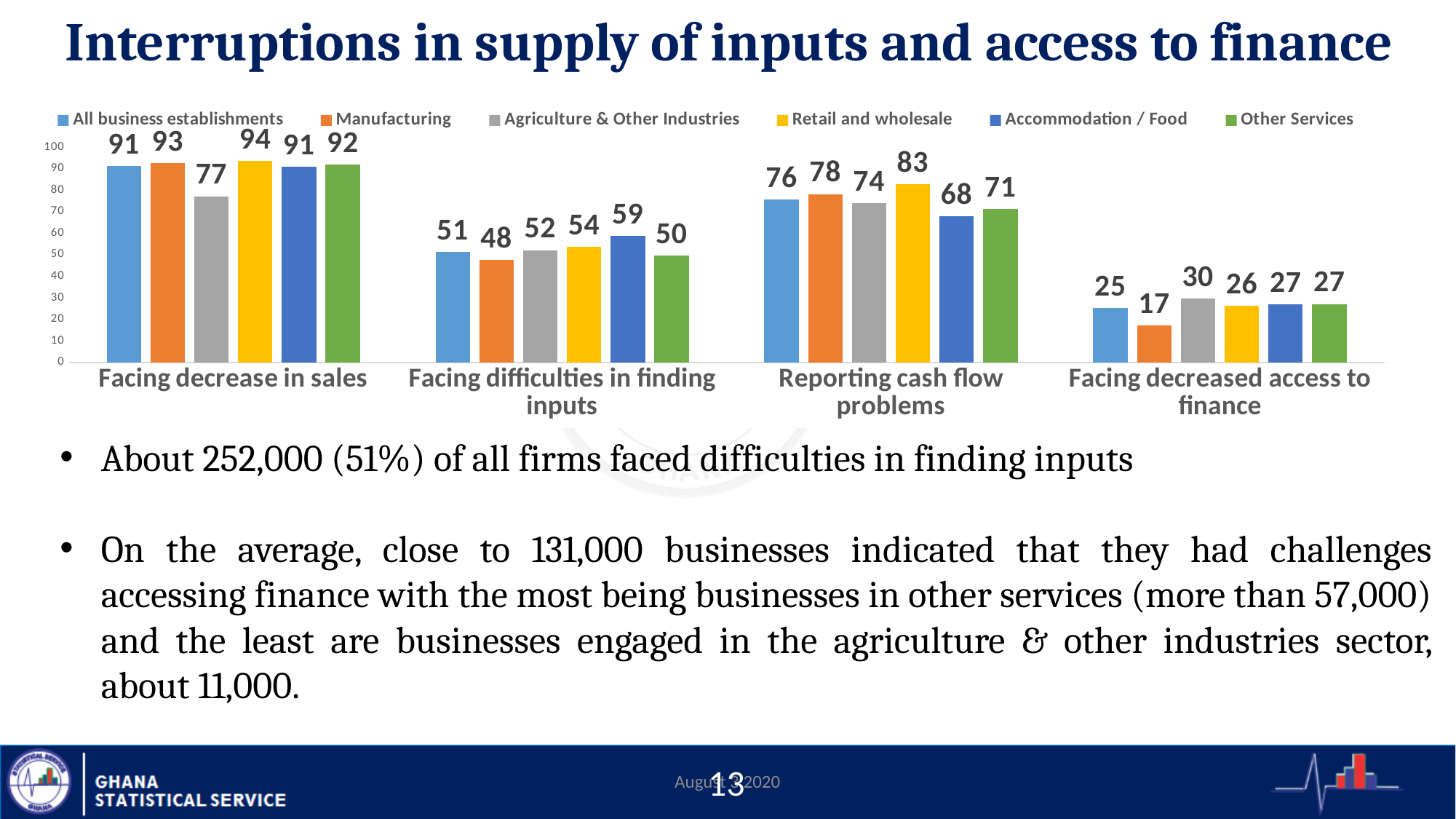
How many categories are shown on the x axis? 4 What is the value for Accommodation / Food in the 'Facing difficulties in finding inputs' category? 59 What colour are the bars for Retail and wholesale? Yellow Which series has the lowest value in the 'Facing decreased access to finance' category? Manufacturing What is the difference between the Retail and wholesale and Accommodation / Food values in the 'Reporting cash flow problems' category? 15 What is the value for Retail and wholesale in the 'Reporting cash flow problems' category? 83 What is the value for Manufacturing in the 'Facing decrease in sales' category? 93 Which series has the highest value in the 'Facing decrease in sales' category? Retail and wholesale Is the value for Agriculture & Other Industries in the 'Facing decrease in sales' category greater or less than 80? less How many series does the legend list? 6 In the 'Facing difficulties in finding inputs' category, which is larger: Agriculture & Other Industries or Other Services? Agriculture & Other Industries What kind of chart is shown on the slide? Bar chart